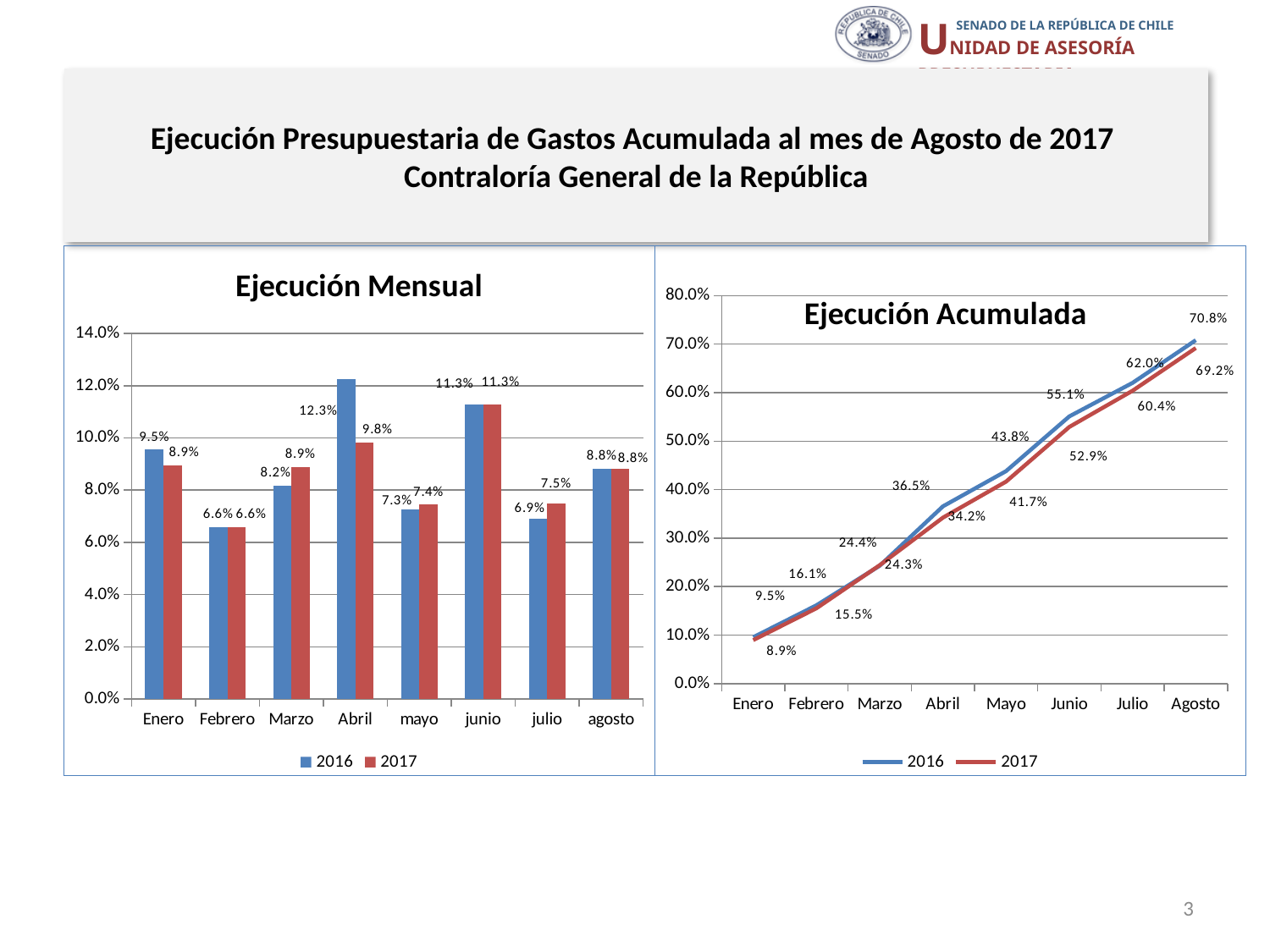
In the 'Ejecución Acumulada' chart, do the values rise or fall from Enero to Agosto? Rise In the 'Ejecución Acumulada' chart, what is the 2017 value for Agosto? 69.2% What kind of chart is 'Ejecución Mensual'? Bar chart In the 'Ejecución Mensual' chart, what is the difference between the 2016 and 2017 values for Abril? 2.5% In the 'Ejecución Acumulada' chart, what is the 2016 value for Mayo? 43.8% In the 'Ejecución Mensual' chart, which month has the lowest 2017 value? Febrero In the 'Ejecución Mensual' chart, what is the 2016 value for Abril? 12.3% In the 'Ejecución Mensual' chart, which is larger for Marzo: the 2016 value or the 2017 value? 2017 How many series does the legend of the 'Ejecución Acumulada' chart list? 2 How many months are shown on the x axis of the 'Ejecución Acumulada' chart? 8 In the 'Ejecución Mensual' chart, which month has the highest 2016 value? Abril In the 'Ejecución Mensual' chart, what is the 2017 value for julio? 7.5%